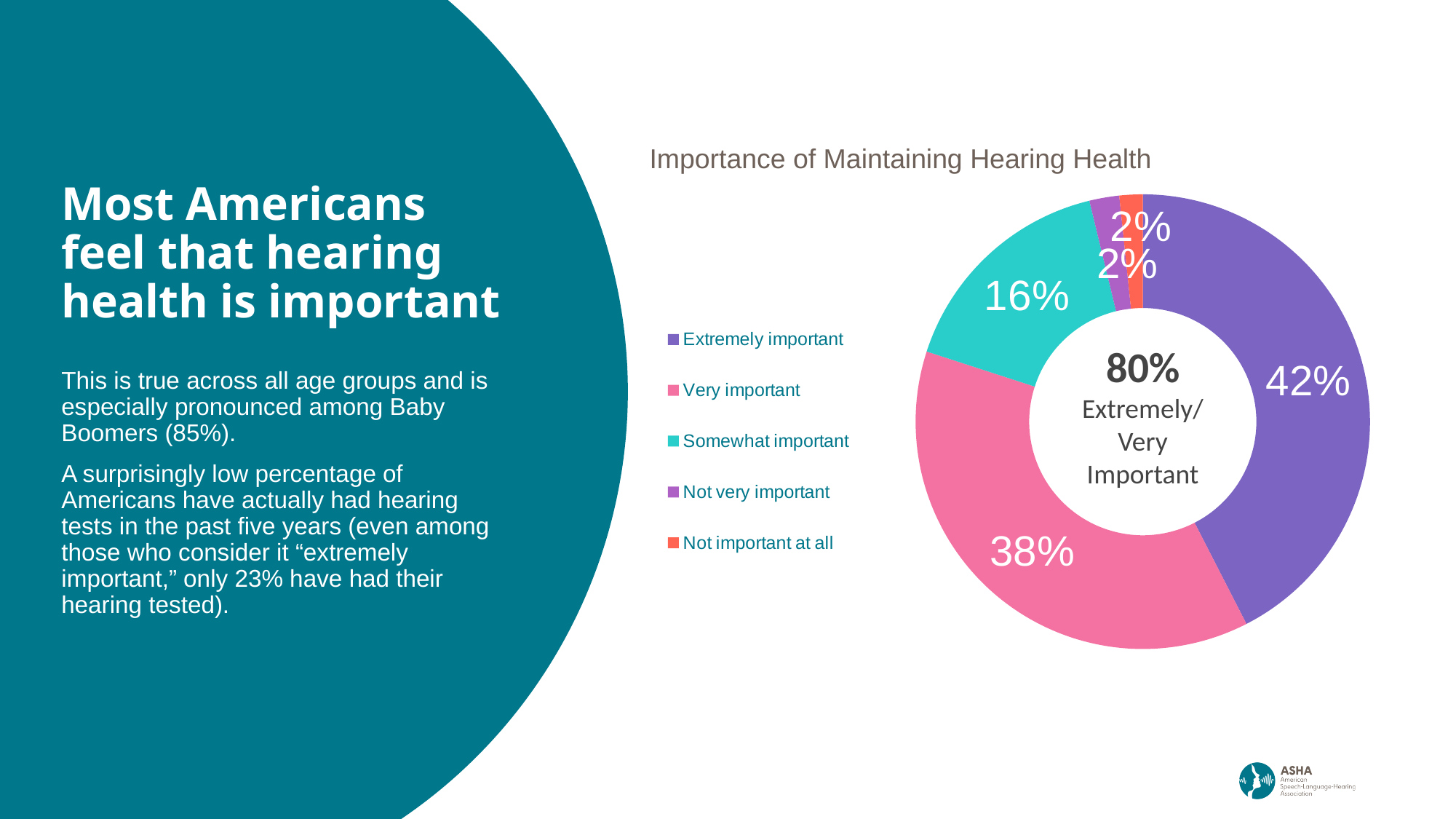
What percentage of respondents rated maintaining hearing health as Very important? 38% What percentage of respondents rated maintaining hearing health as Extremely important? 42% Which colour represents the Somewhat important category? Teal Which category has the largest share of the chart? Extremely important What percentage of respondents rated maintaining hearing health as Not very important? 2% How many categories does the legend list? 5 Which is larger, the Very important slice or the Somewhat important slice? Very important What is the combined percentage for Extremely important and Very important shown in the centre of the chart? 80% What kind of chart is shown on the slide? Pie chart (donut) What percentage of respondents rated maintaining hearing health as Somewhat important? 16% What is the difference in percentage points between the Extremely important and Very important slices? 4 What is the title of the chart? Importance of Maintaining Hearing Health